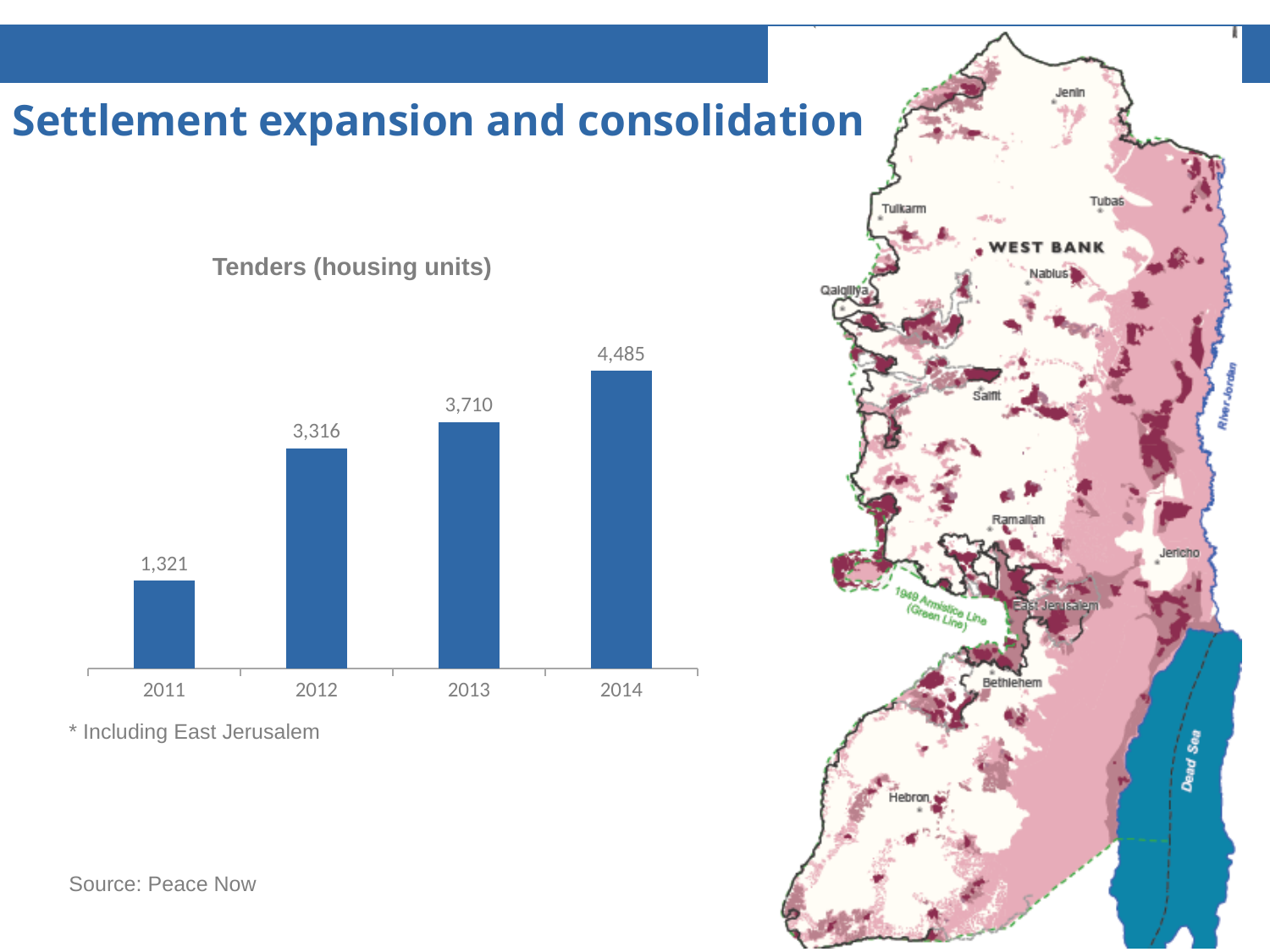
Which year has more tenders (housing units), 2012 or 2013? 2013 How many years are shown on the tenders (housing units) chart? 4 What is the title of the chart on the slide? Tenders (housing units) What is the value of tenders (housing units) for 2011? 1,321 What is the value of tenders (housing units) for 2013? 3,710 What is the value of tenders (housing units) for 2014? 4,485 Do the tenders (housing units) values rise or fall from 2011 to 2014? Rise Which year has the lowest number of tenders (housing units)? 2011 What kind of chart is used to show tenders (housing units)? Bar chart Which year has the highest number of tenders (housing units)? 2014 What is the difference in tenders (housing units) between 2012 and 2011? 1,995 What is the difference in tenders (housing units) between 2014 and 2013? 775